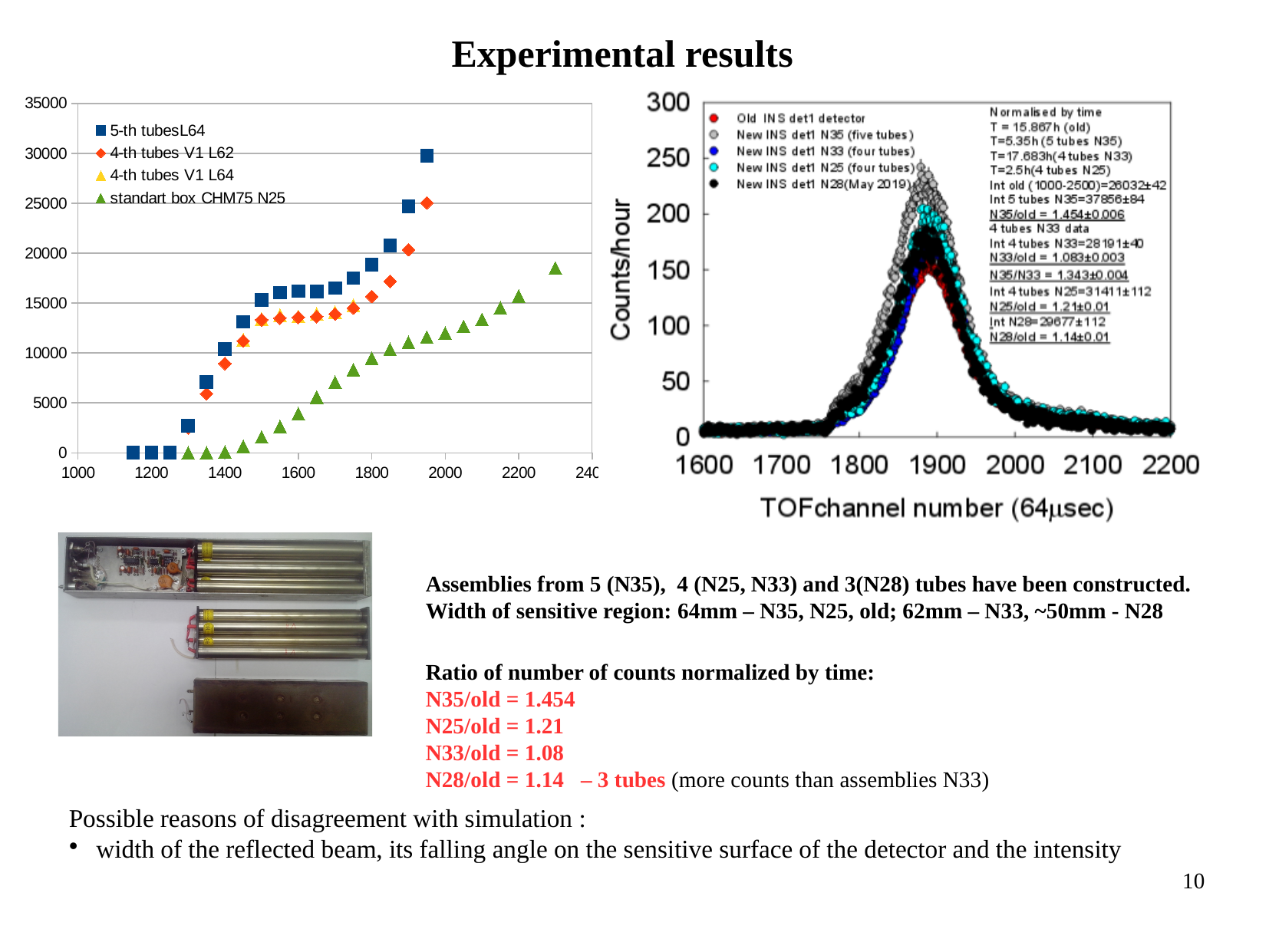
What kind of chart is the chart on the left of the slide? scatter chart In the right chart, is the peak value of New INS det1 N35 (five tubes) greater or less than 200 counts/hour? greater How many series does the legend of the left chart list? 4 In the right chart, is the peak value of the Old INS det1 detector greater or less than 200 counts/hour? less In the left chart, which series has the highest value at x = 1950? 5-th tubesL64 What is the label of the x axis of the right chart? TOFchannel number (64μsec) In the left chart, do the values for standart box CHM75 N25 rise or fall as x increases? rise In the left chart, is the value for standart box CHM75 N25 at x = 2300 greater or less than 15000? greater How many series does the legend of the right chart (Counts/hour vs TOF channel number) list? 5 In the left chart, at x = 1900, which series has the larger value: 5-th tubesL64 or 4-th tubes V1 L62? 5-th tubesL64